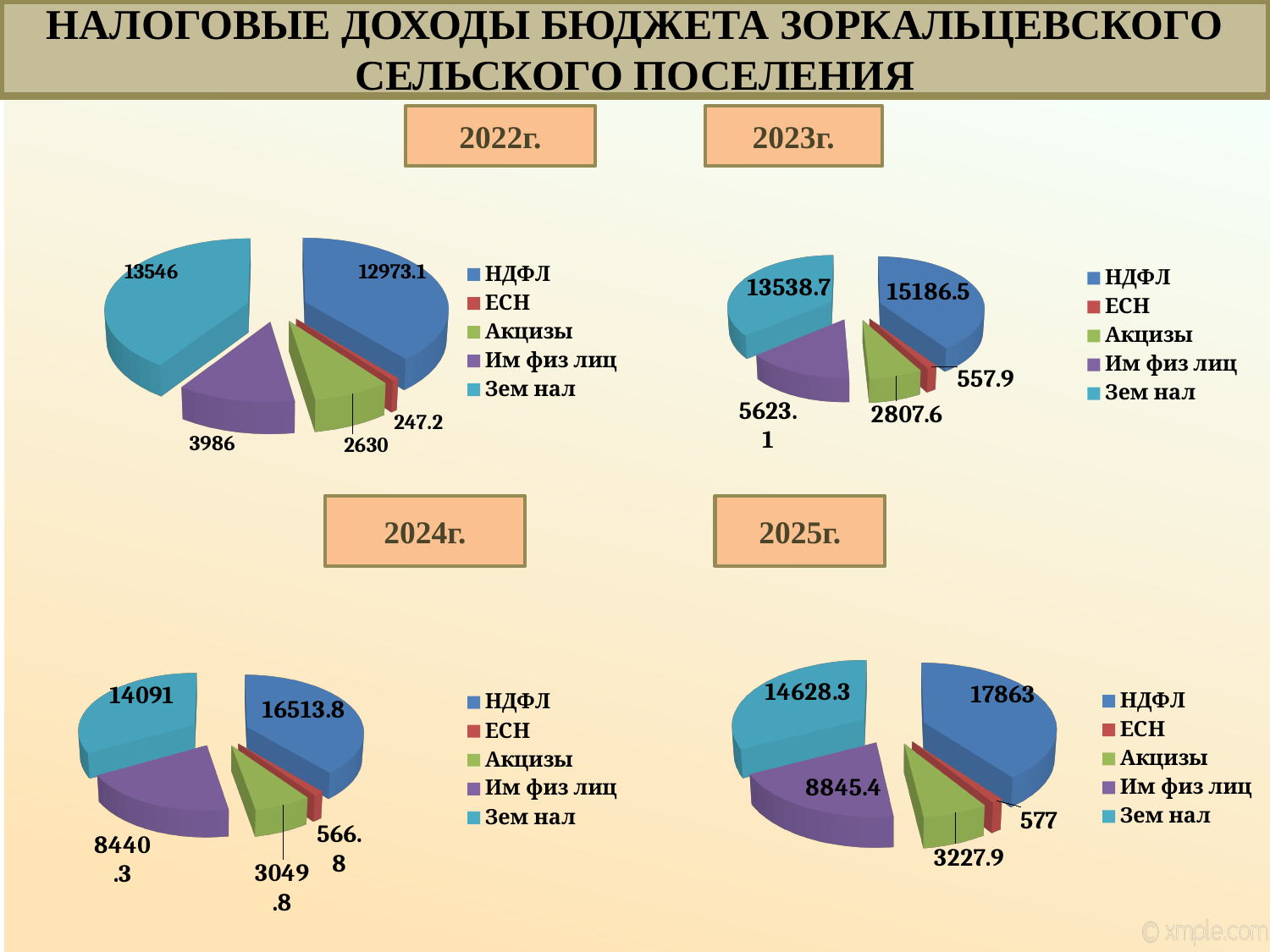
In the 2022г. chart, what is the difference between Зем нал and НДФЛ? 572.9 In the 2023г. chart, what is the value for НДФЛ? 15186.5 In the 2024г. chart, what is the value for Им физ лиц? 8440.3 Across the four charts from 2022г. to 2025г., does the value for НДФЛ rise or fall? rise What kind of chart is used for the 2022г. data? pie chart In the 2023г. chart, which is larger: Им физ лиц or Акцизы? Им физ лиц In the 2025г. chart, what is the value for Акцизы? 3227.9 In the 2022г. chart, what is the value for Зем нал? 13546 How many categories does the legend of the 2024г. chart list? 5 In the 2022г. chart, which category has the largest value? Зем нал In the 2025г. chart, which category has the smallest value? ЕСН In the 2025г. chart, what is the difference between НДФЛ and Зем нал? 3234.7